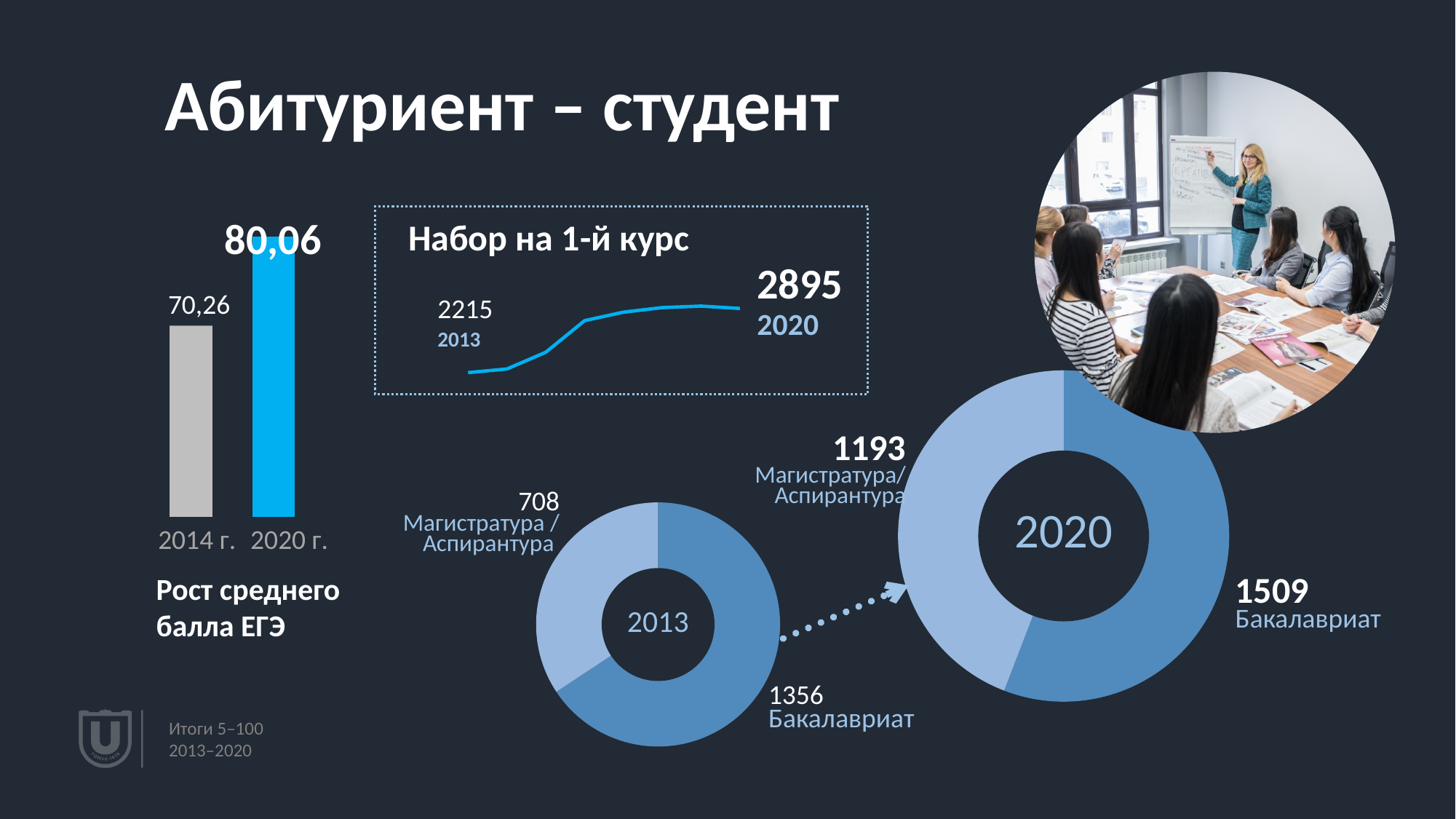
On the line chart 'Набор на 1-й курс', what is the value for 2020? 2895 On the line chart 'Набор на 1-й курс', by how much did the value increase from 2013 to 2020? 680 On the bar chart 'Рост среднего балла ЕГЭ', which year has the higher value? 2020 г. On the bar chart 'Рост среднего балла ЕГЭ', how many bars are shown? 2 On the 2020 donut chart, what is the value for Магистратура/Аспирантура? 1193 On the 2013 donut chart, what is the value for Бакалавриат? 1356 On the 2020 donut chart, which segment is larger, Бакалавриат or Магистратура/Аспирантура? Бакалавриат On the line chart 'Набор на 1-й курс', what is the value for 2013? 2215 What kind of chart is 'Рост среднего балла ЕГЭ'? bar chart On the bar chart 'Рост среднего балла ЕГЭ', what is the value for 2014 г.? 70,26 On the bar chart 'Рост среднего балла ЕГЭ', what is the value for 2020 г.? 80,06 On the line chart 'Набор на 1-й курс', do the values rise or fall from 2013 to 2020? rise